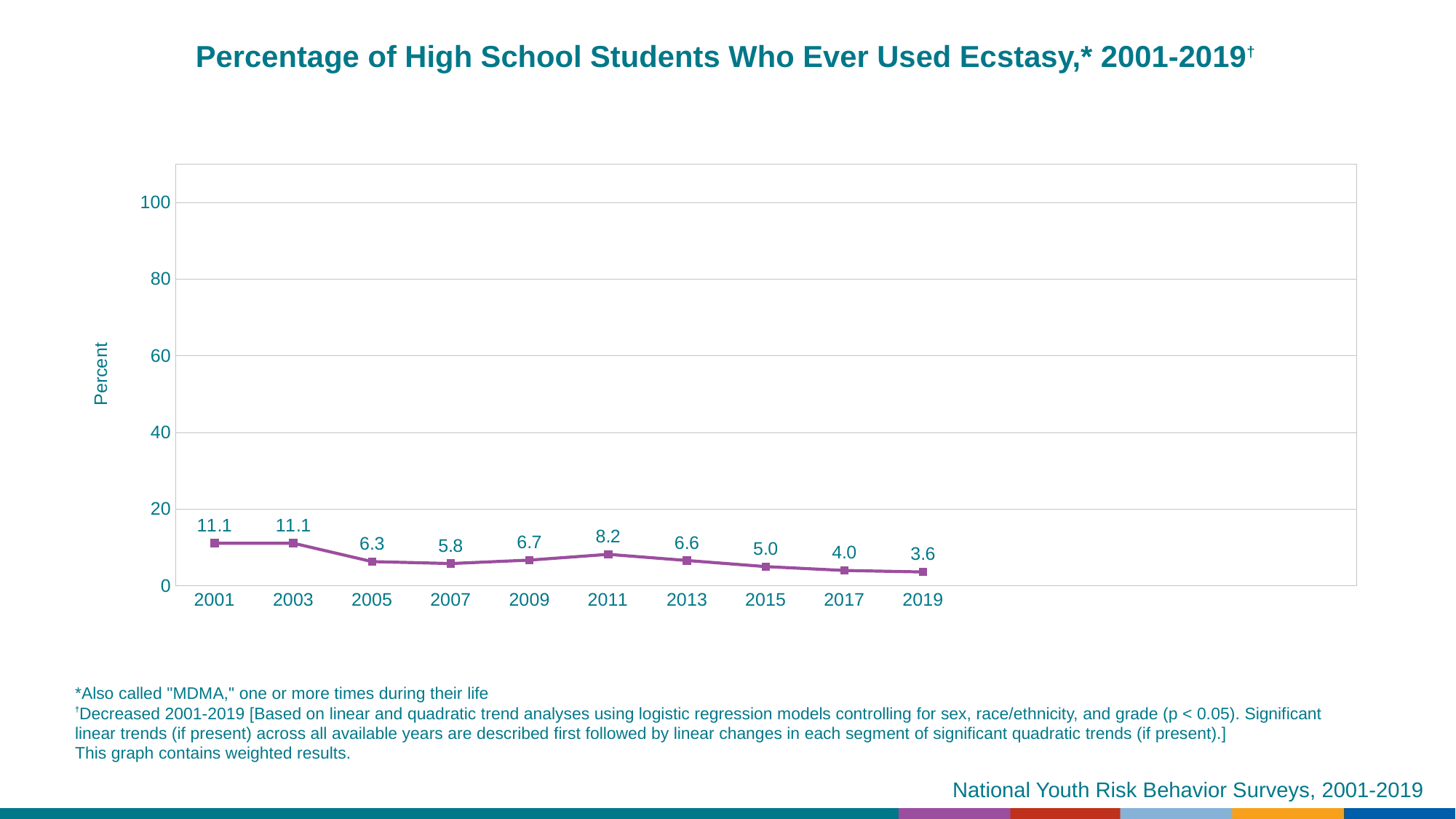
What is the difference between the values for 2001 and 2019? 7.5 What is the highest value shown on the chart? 11.1 Which year has the larger value, 2009 or 2013? 2009 How many years are plotted on the x axis? 10 What is the value plotted for 2007? 5.8 What is the label on the y axis? Percent Overall, do the values rise or fall from 2001 to 2019? fall What kind of chart is shown on the slide? line chart What is the value plotted for 2019? 3.6 Which year has the lowest value on the chart? 2019 Is the value for 2003 greater or less than 20? less What percentage of high school students had ever used ecstasy in 2011? 8.2